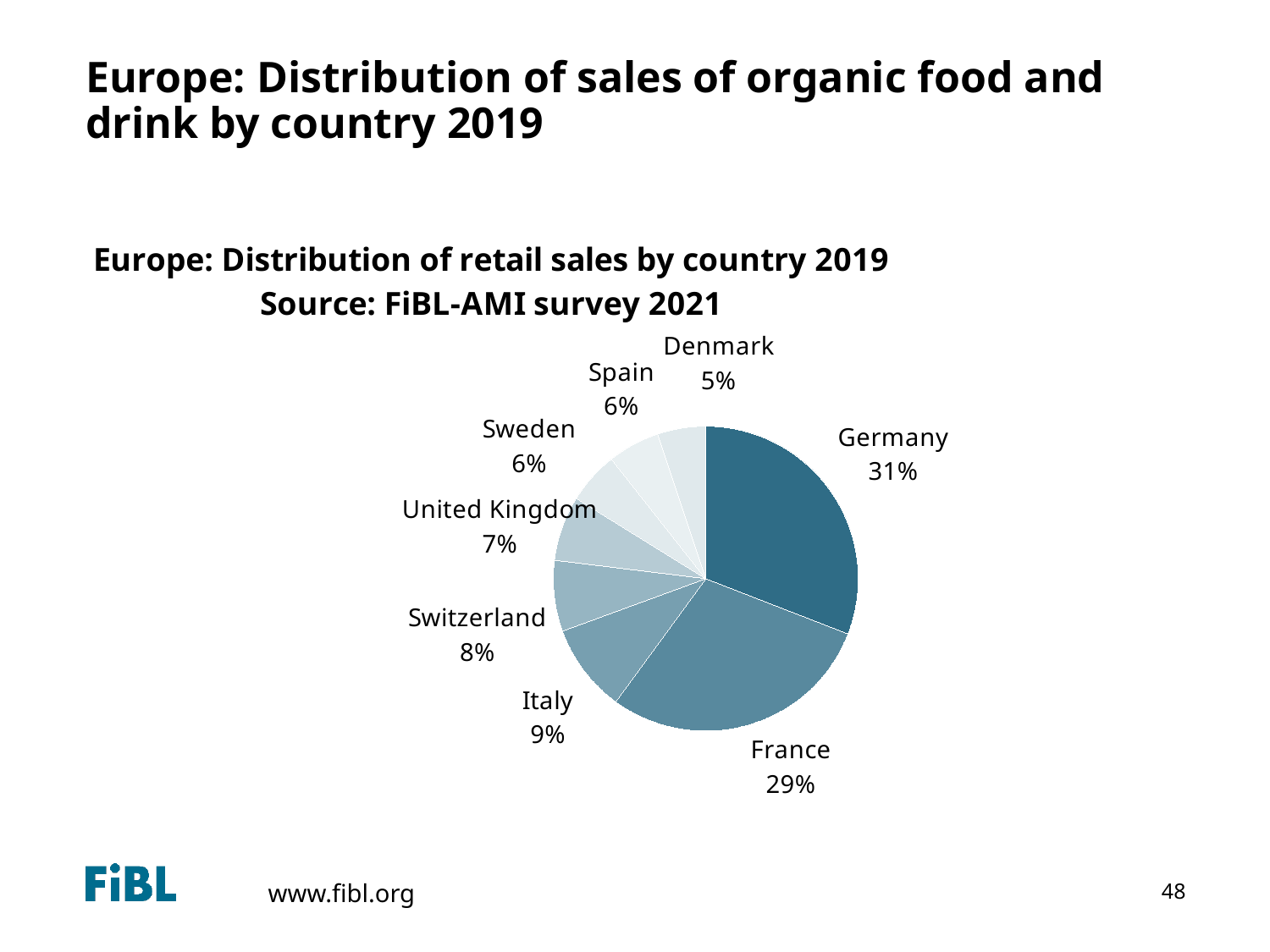
Which has a larger share of retail sales, Italy or Switzerland? Italy What is the difference in percentage points between Germany's and France's shares? 2 percentage points How many countries are shown in the pie chart? 8 Which country has the smallest share of retail sales? Denmark What share of retail sales does Switzerland account for? 8% What type of chart is shown on the slide? Pie chart What source is cited for the chart? FiBL-AMI survey 2021 Which country has the largest share of retail sales? Germany What is the difference in percentage points between Italy's and Denmark's shares? 4 percentage points What share of retail sales does France account for? 29% What share of retail sales does Germany account for? 31% What share of retail sales does the United Kingdom account for? 7%